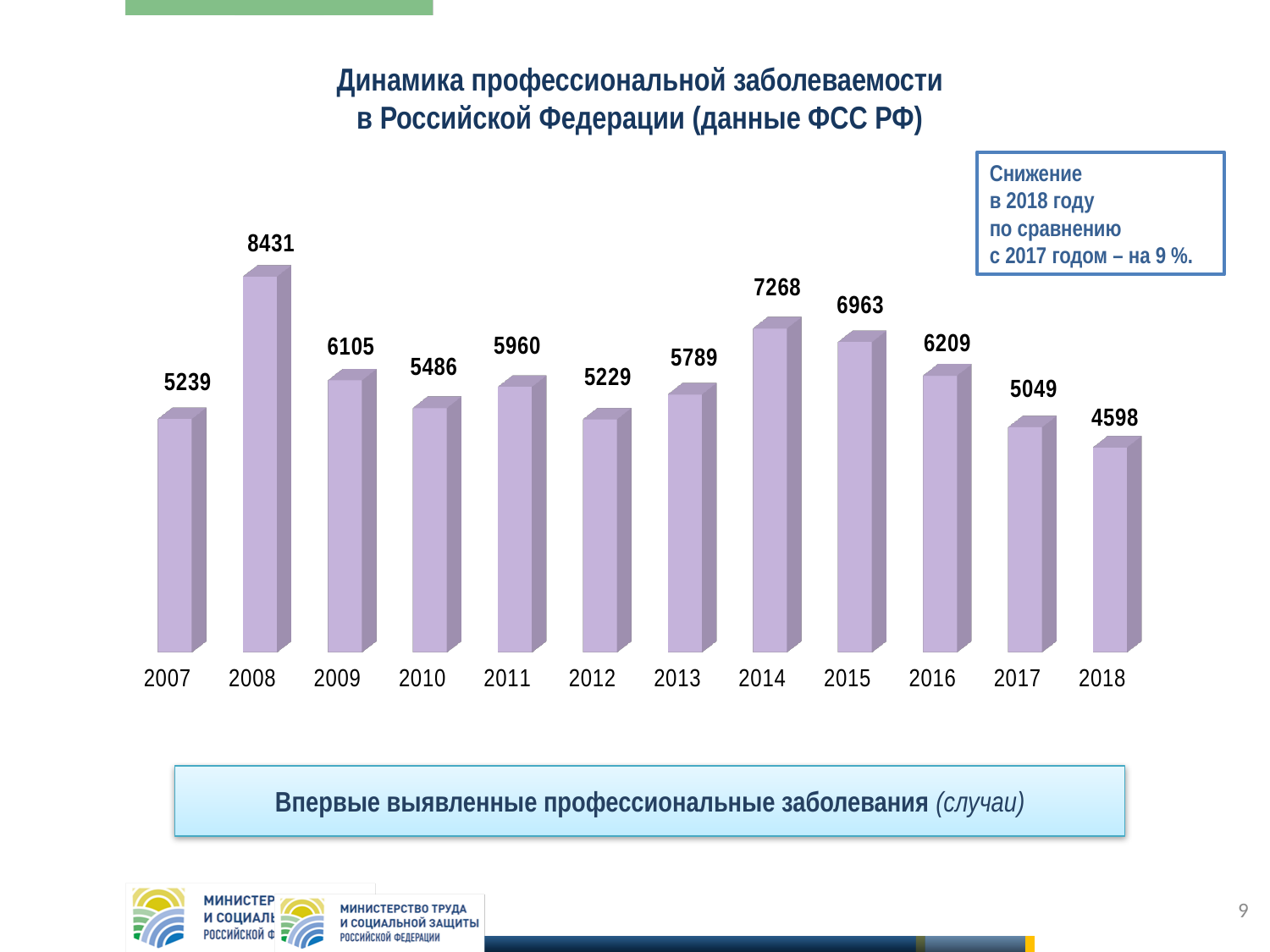
Which year has the lowest value? 2018 How many years are shown on the x axis? 12 What is the value for 2014? 7268 What is the value for 2018? 4598 What is the difference between the values for 2017 and 2018? 451 Which year has the highest value? 2008 What kind of chart is shown on the slide? bar chart What is the difference between the values for 2008 and 2009? 2326 Do the values rise or fall from 2015 to 2018? fall Which is larger, the value for 2014 or the value for 2015? 2014 Which is larger, the value for 2010 or the value for 2011? 2011 What is the value for 2008? 8431